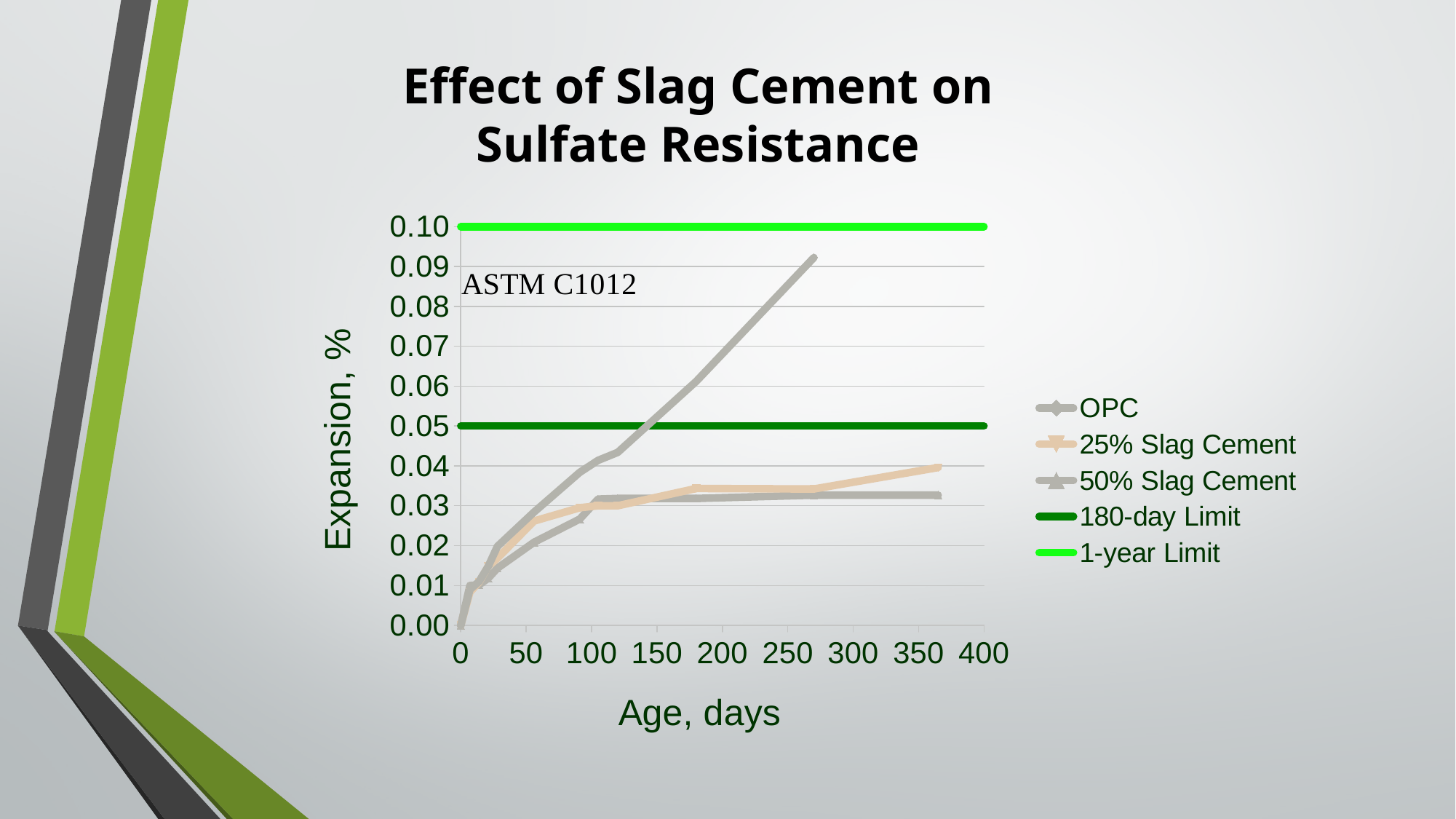
What is the label of the y axis? Expansion, % Which of the three cement series reaches the highest expansion? OPC Does the expansion of the OPC series rise or fall as age increases? rise Is the expansion of the 50% Slag Cement series at about 365 days greater or less than 0.05? less What kind of chart is shown on the slide? line chart Is the final expansion value of the OPC series greater or less than 0.05? greater At what expansion value is the 180-day Limit line drawn? 0.05 Which of the three cement series has the lowest expansion at the end of its curve? 50% Slag Cement How many series does the legend list? 5 At what expansion value is the 1-year Limit line drawn? 0.10 Is the expansion of the 25% Slag Cement series at about 365 days greater or less than 0.05? less What is the title of the chart? Effect of Slag Cement on Sulfate Resistance